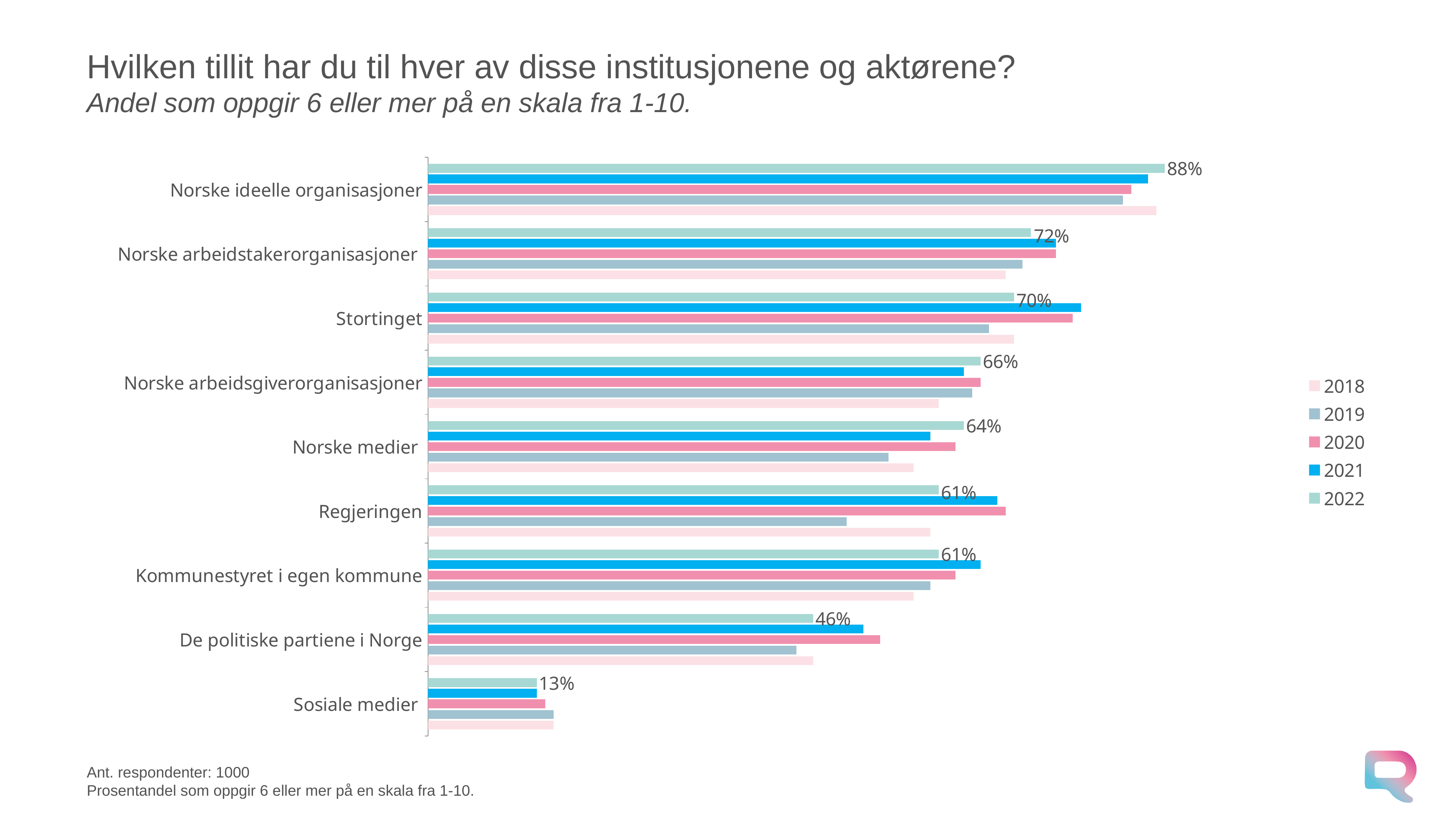
What is the difference between the 2022 values for Norske ideelle organisasjoner and Sosiale medier? 75 percentage points What is the 2022 value for Norske ideelle organisasjoner? 88% How many institutions or actors are listed on the chart? 9 For Regjeringen, which is larger: the 2021 bar or the 2022 bar? 2021 Which year does the darkest blue bar represent according to the legend? 2021 Which category has the highest 2022 value? Norske ideelle organisasjoner What is the 2022 value for Stortinget? 70% What is the 2022 value for Sosiale medier? 13% What is the 2022 value for De politiske partiene i Norge? 46% What kind of chart is shown on the slide? bar chart Which category has the lowest 2022 value? Sosiale medier How many series does the legend list? 5